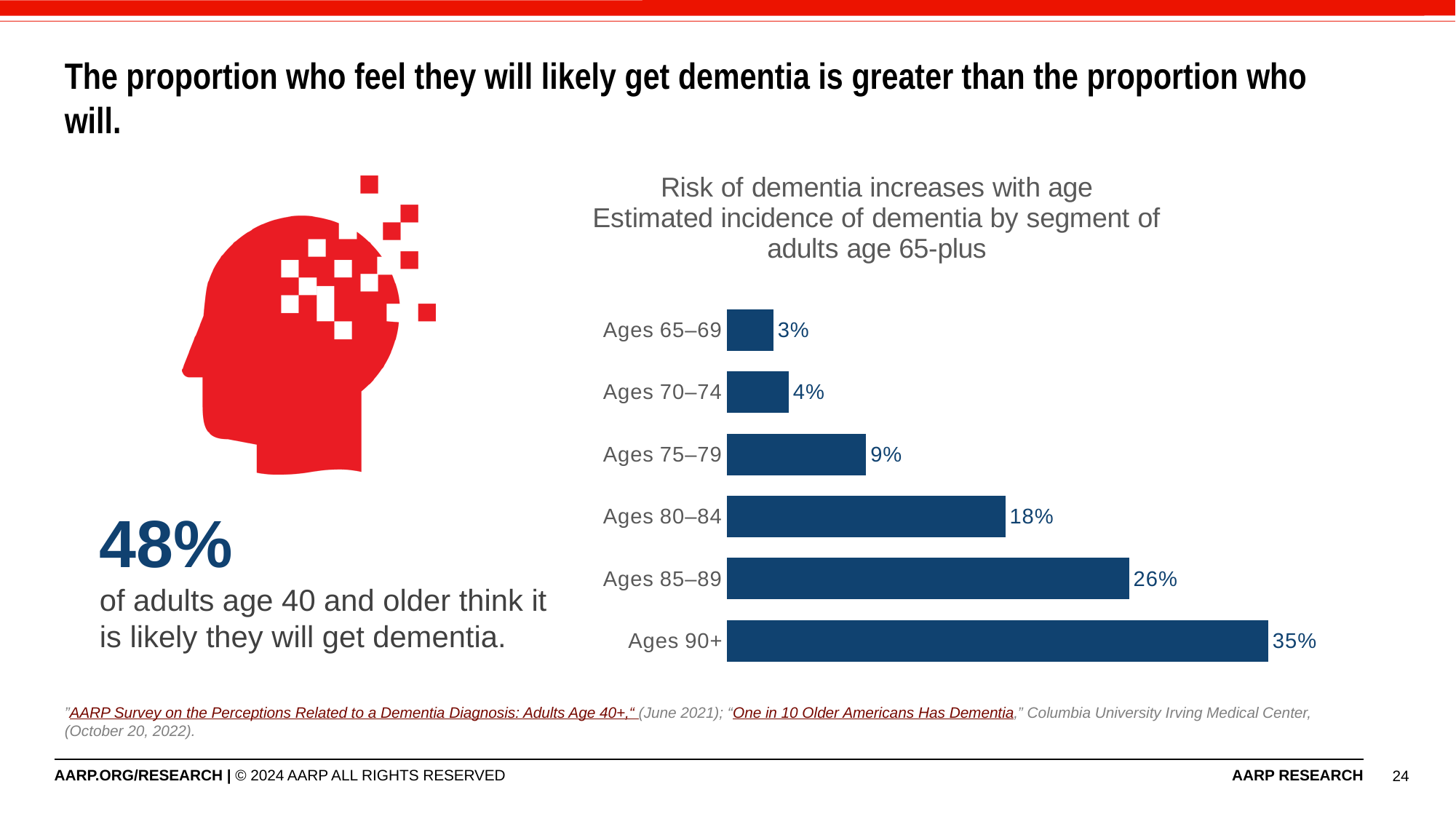
Which age segment has the lowest estimated incidence of dementia? Ages 65–69 How many age segments are shown in the chart? 6 Do the estimated incidence values rise or fall as the age segments get older? Rise What is the title of the chart? Risk of dementia increases with age Estimated incidence of dementia by segment of adults age 65-plus What kind of chart is used to show estimated incidence of dementia by age segment? Bar chart What is the difference in estimated incidence between Ages 90+ and Ages 85–89? 9% What is the estimated incidence of dementia for Ages 65–69? 3% Which has a higher estimated incidence of dementia, Ages 70–74 or Ages 75–79? Ages 75–79 What is the estimated incidence of dementia for Ages 80–84? 18% Which age segment has the highest estimated incidence of dementia? Ages 90+ What is the estimated incidence of dementia for Ages 85–89? 26% What is the difference in estimated incidence between Ages 80–84 and Ages 75–79? 9%